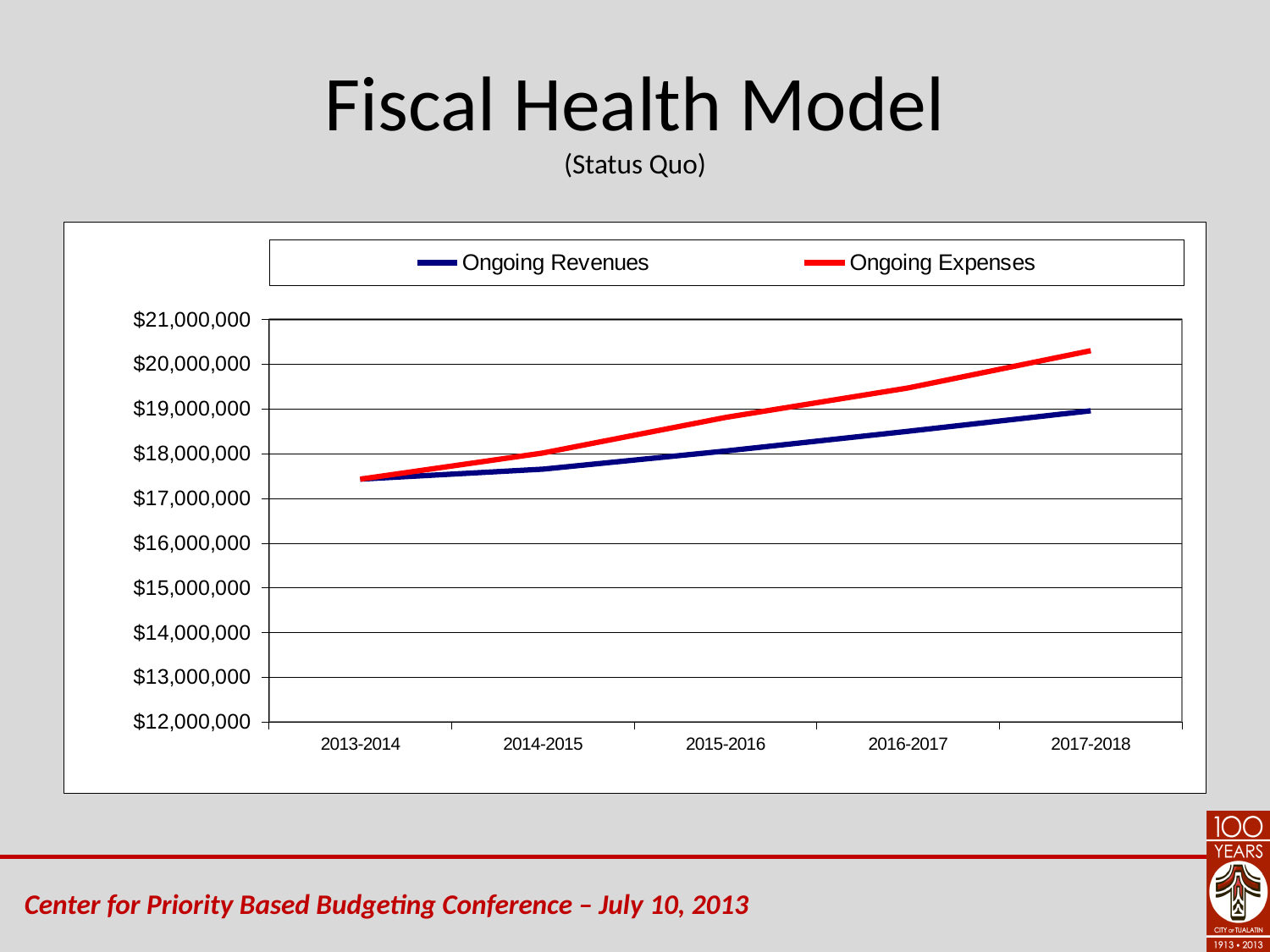
Is the value for Ongoing Revenues in 2013-2014 greater or less than $17,000,000? greater Which series is drawn in red? Ongoing Expenses How many fiscal years are plotted along the x axis? 5 In 2017-2018, which is larger: Ongoing Revenues or Ongoing Expenses? Ongoing Expenses Is the value for Ongoing Revenues in 2016-2017 greater or less than $18,000,000? greater Is the value for Ongoing Expenses in 2017-2018 greater or less than $20,000,000? greater How many series does the legend list? 2 What is the subtitle shown under the chart title 'Fiscal Health Model'? (Status Quo) What kind of chart is shown on the slide? Line chart Do the Ongoing Expenses values rise or fall from 2013-2014 to 2017-2018? Rise In which fiscal year is Ongoing Revenues at its lowest? 2013-2014